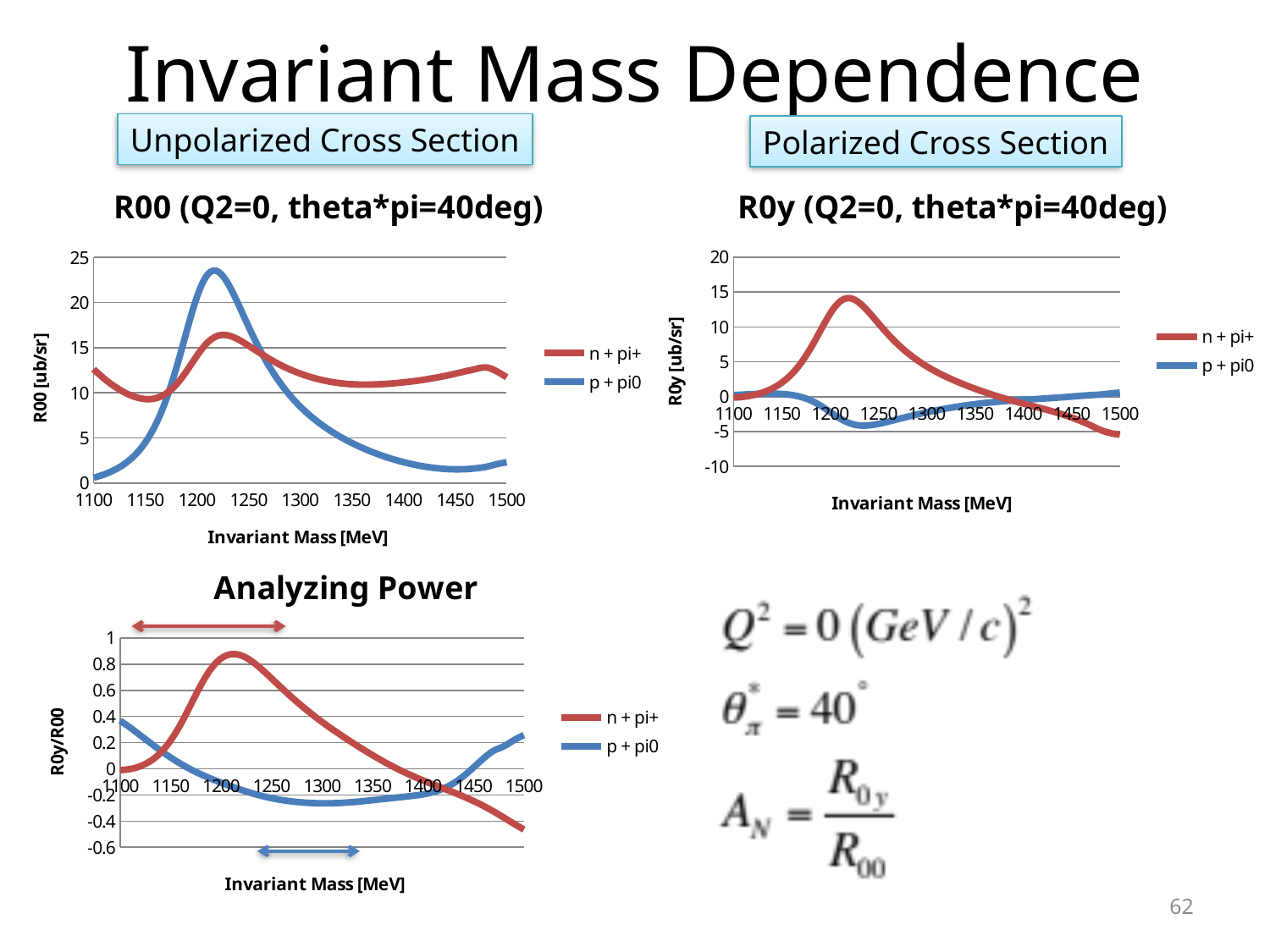
What is the y-axis label of the Analyzing Power chart? R0y/R00 How many series does the legend of the R0y (Q2=0, theta*pi=40deg) chart list? 2 In the R00 (Q2=0, theta*pi=40deg) chart, is the value of p + pi0 at 1100 MeV greater or less than 5? less In the R0y (Q2=0, theta*pi=40deg) chart, is the value of n + pi+ at 1500 MeV greater or less than 0? less In the R00 (Q2=0, theta*pi=40deg) chart, which series reaches the higher peak, n + pi+ or p + pi0? p + pi0 In the R0y (Q2=0, theta*pi=40deg) chart, which series reaches the higher peak, n + pi+ or p + pi0? n + pi+ In the R0y (Q2=0, theta*pi=40deg) chart, is the peak value of the n + pi+ series greater or less than 10? greater In the Analyzing Power chart, which series has the larger value at 1500 MeV, n + pi+ or p + pi0? p + pi0 What type of chart is the R00 (Q2=0, theta*pi=40deg) chart? line chart